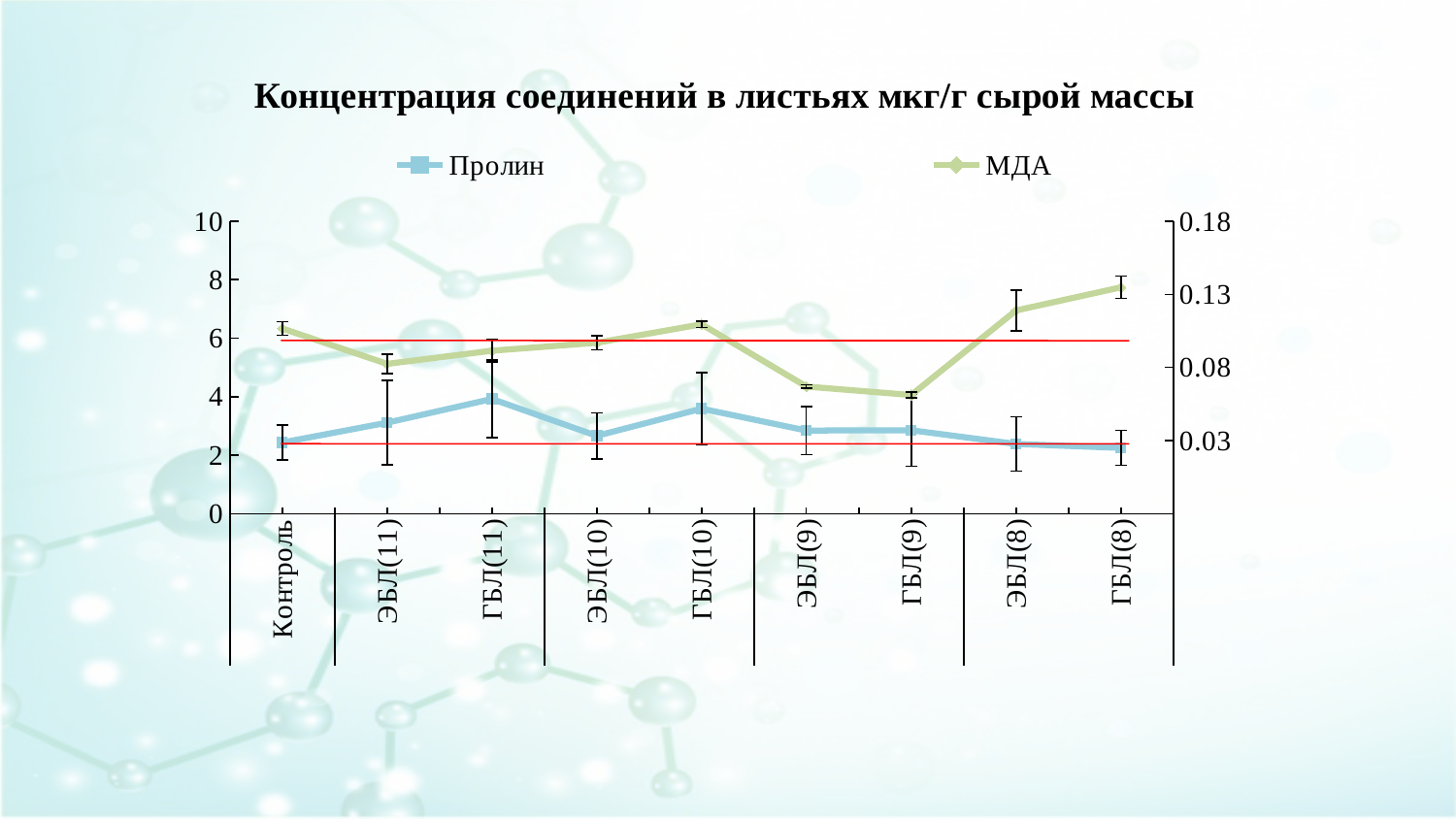
Is the МДА value for ГБЛ(9) greater or less than 0.08? less Is the Пролин value for Контроль greater or less than 4? less Is the МДА value for ЭБЛ(8) greater or less than 0.08? greater For which category is the Пролин value highest? ГБЛ(11) What is the title of the chart? Концентрация соединений в листьях мкг/г сырой массы Does the МДА line rise or fall from ГБЛ(9) to ГБЛ(8)? rises How many series does the legend list? 2 For which category is the МДА value highest? ГБЛ(8) Which has the larger Пролин value, Контроль or ГБЛ(11)? ГБЛ(11) Which series is drawn in blue? Пролин How many categories are plotted along the x axis? 9 What kind of chart is shown on the slide? Line chart